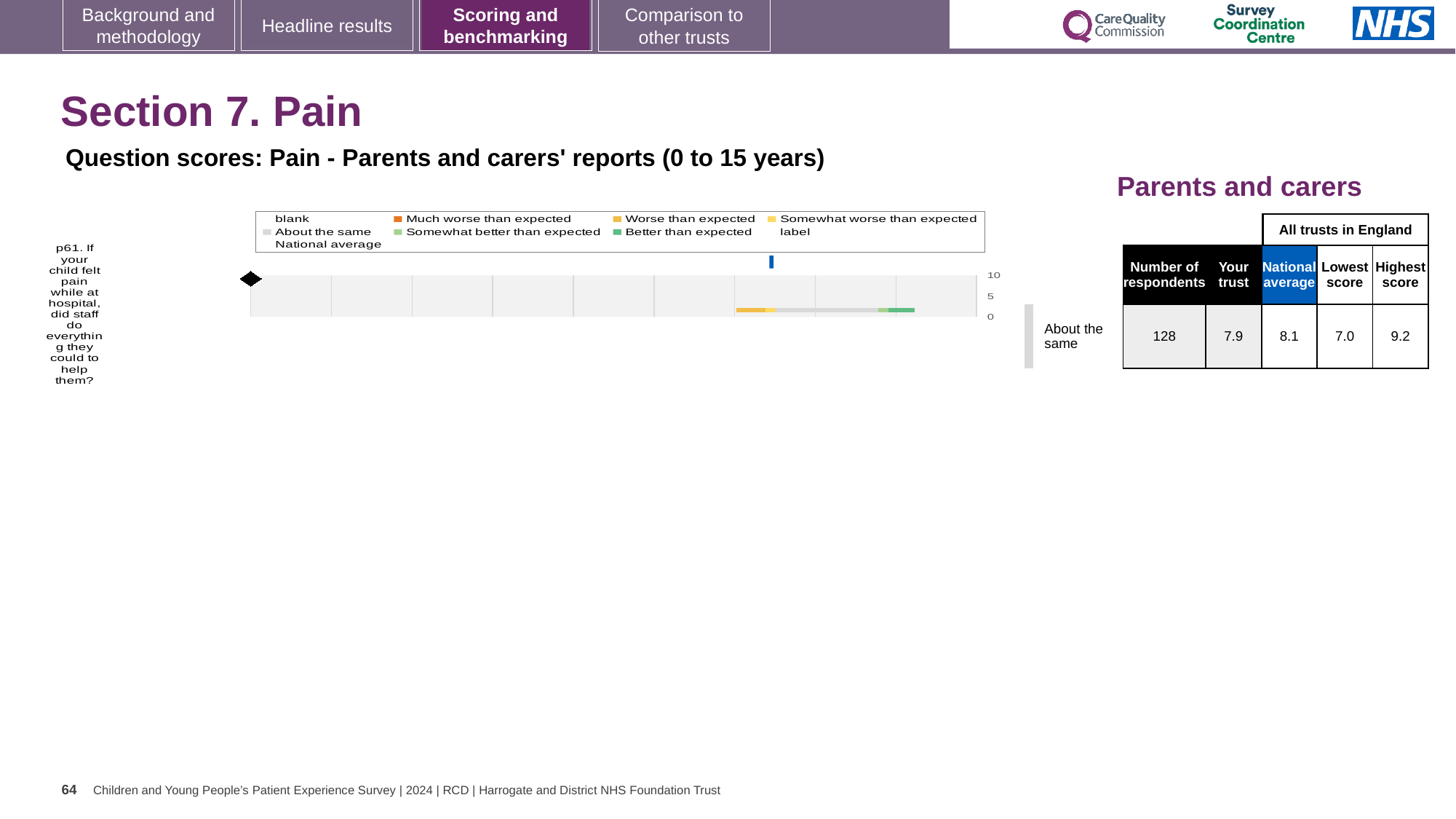
What is the number of respondents for question p61? 128 What is the 'Your trust' score for question p61 in the table? 7.9 What is the highest value shown on the chart's axis? 10 How many survey questions are plotted in the chart? 1 What kind of chart is shown on the slide? bar chart What is the lowest score among all trusts in England for question p61? 7.0 Which colour does the legend use for 'Better than expected'? green What benchmark category is question p61 assigned to? About the same What is the difference between the highest score and the lowest score for question p61? 2.2 What is the national average score for question p61? 8.1 What is the highest score among all trusts in England for question p61? 9.2 Which is larger for question p61, the 'Your trust' score or the national average? National average